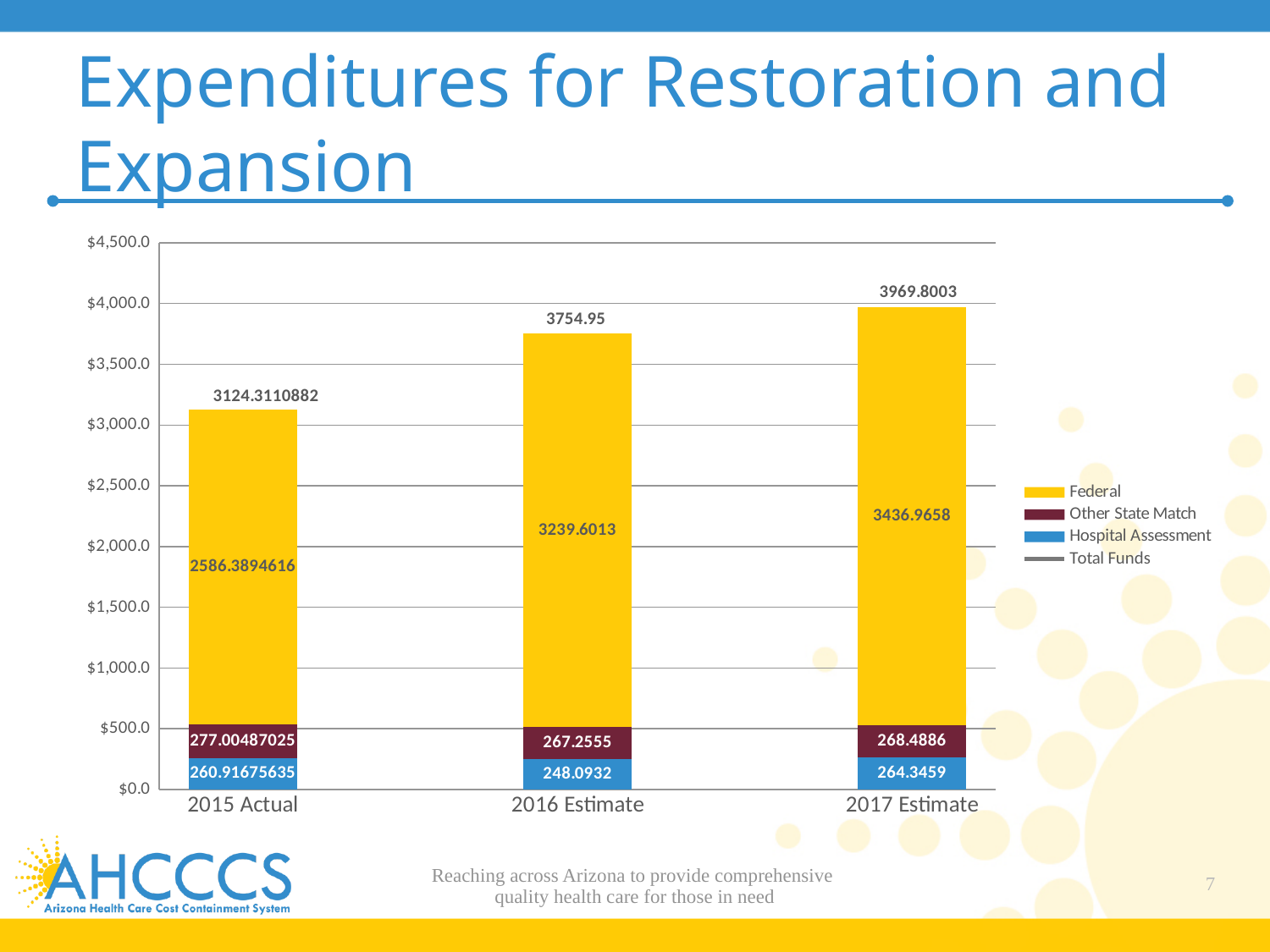
What is the Other State Match value for 2016 Estimate? 267.2555 How many categories are shown on the x axis? 3 Do the Total Funds values rise or fall from 2015 Actual to 2017 Estimate? rise What is the Federal value for 2016 Estimate? 3239.6013 Is the Total Funds value for 2017 Estimate greater or less than $4,000.0? less Is the Hospital Assessment value larger for 2015 Actual or 2016 Estimate? 2015 Actual What is the difference between the Federal values for 2017 Estimate and 2016 Estimate? 197.3645 What is the Total Funds value shown for 2017 Estimate? 3969.8003 What is the Hospital Assessment value for 2015 Actual? 260.91675635 Which category has the lowest Hospital Assessment value? 2016 Estimate How many series does the legend list? 4 Which category has the highest Federal value? 2017 Estimate